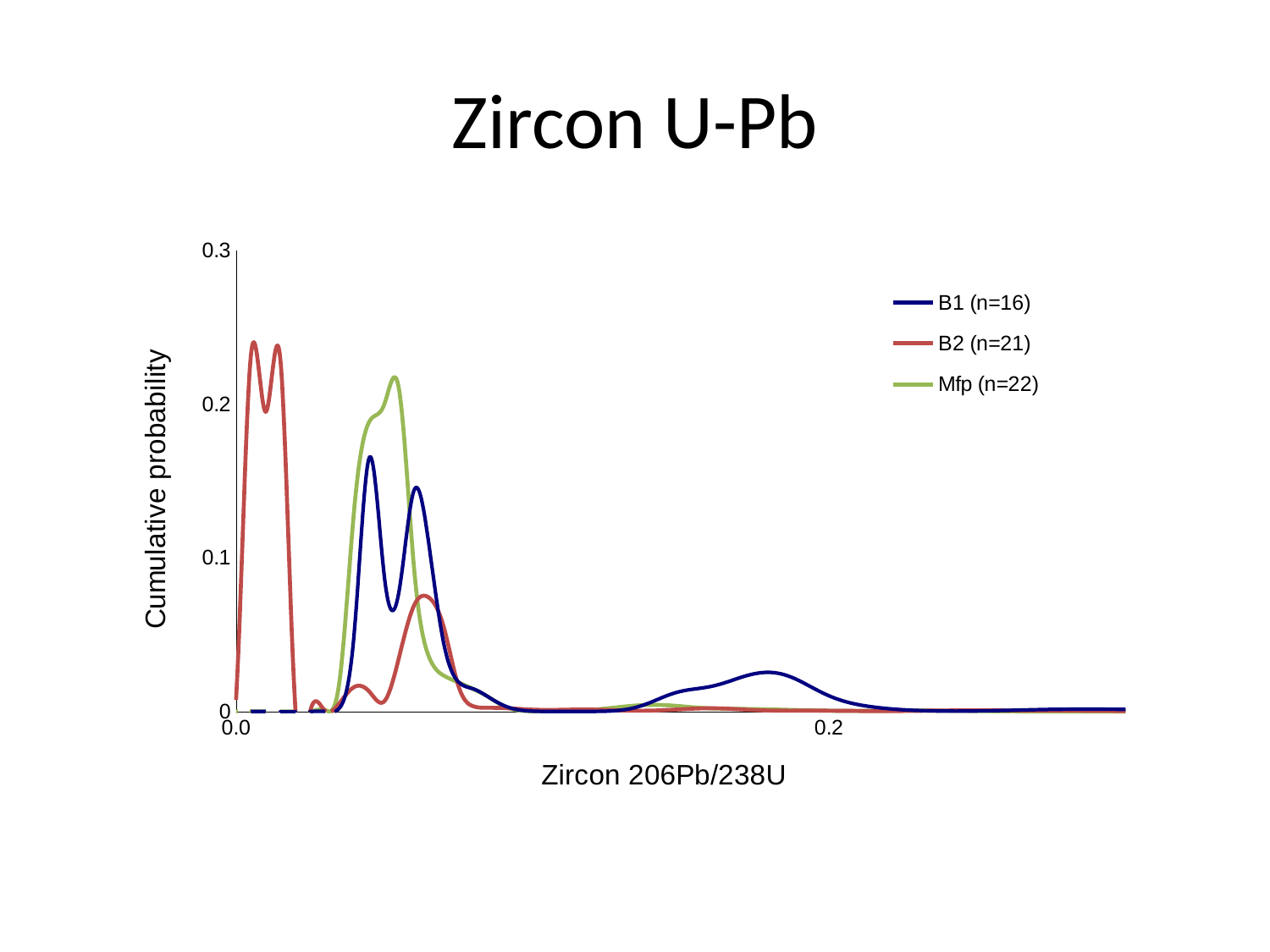
How many samples (n) does the legend give for the B2 series? 21 What is the label of the y axis? Cumulative probability How many samples (n) does the legend give for the Mfp series? 22 What kind of chart is shown on the slide? line chart What is the title of the chart? Zircon U-Pb Is the highest peak of the B1 curve greater or less than 0.2? less Which series has the higher peak, B1 or Mfp? Mfp (n=22) How many series does the legend list? 3 Is the highest peak of the B2 curve greater or less than 0.2? greater Is the highest peak of the B1 curve greater or less than 0.1? greater Which series reaches the highest peak value on the chart? B2 (n=21) How many samples (n) does the legend give for the B1 series? 16